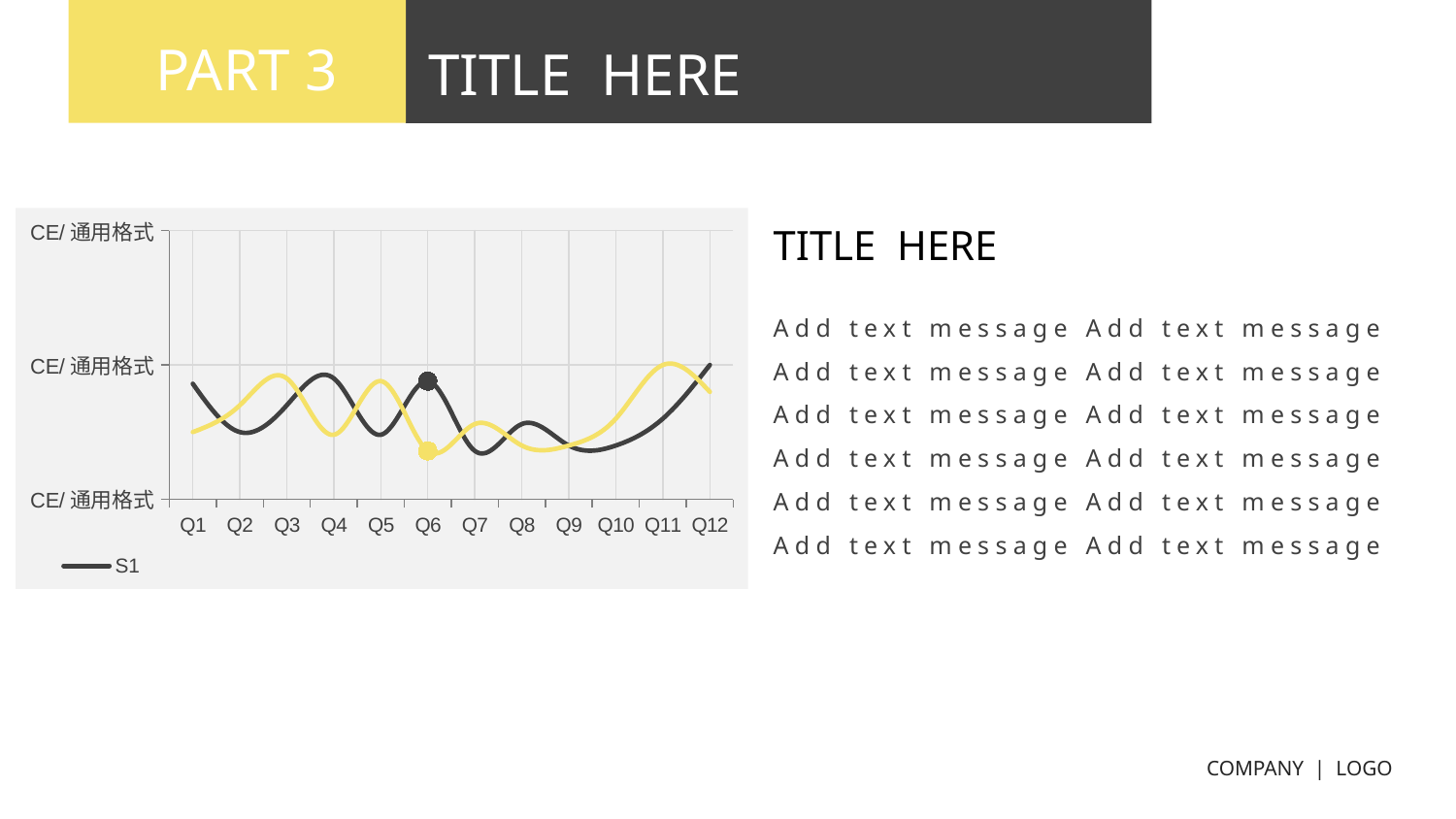
How many series does the chart's legend list? 1 What is the last category label on the x axis of the chart? Q12 At Q6, which line is higher: the dark line or the yellow line? The dark line At which category do both lines have a highlighted marker point? Q6 What is the first category label on the x axis of the chart? Q1 What kind of chart is shown on the slide? Line chart How many categories are shown along the x axis of the chart? 12